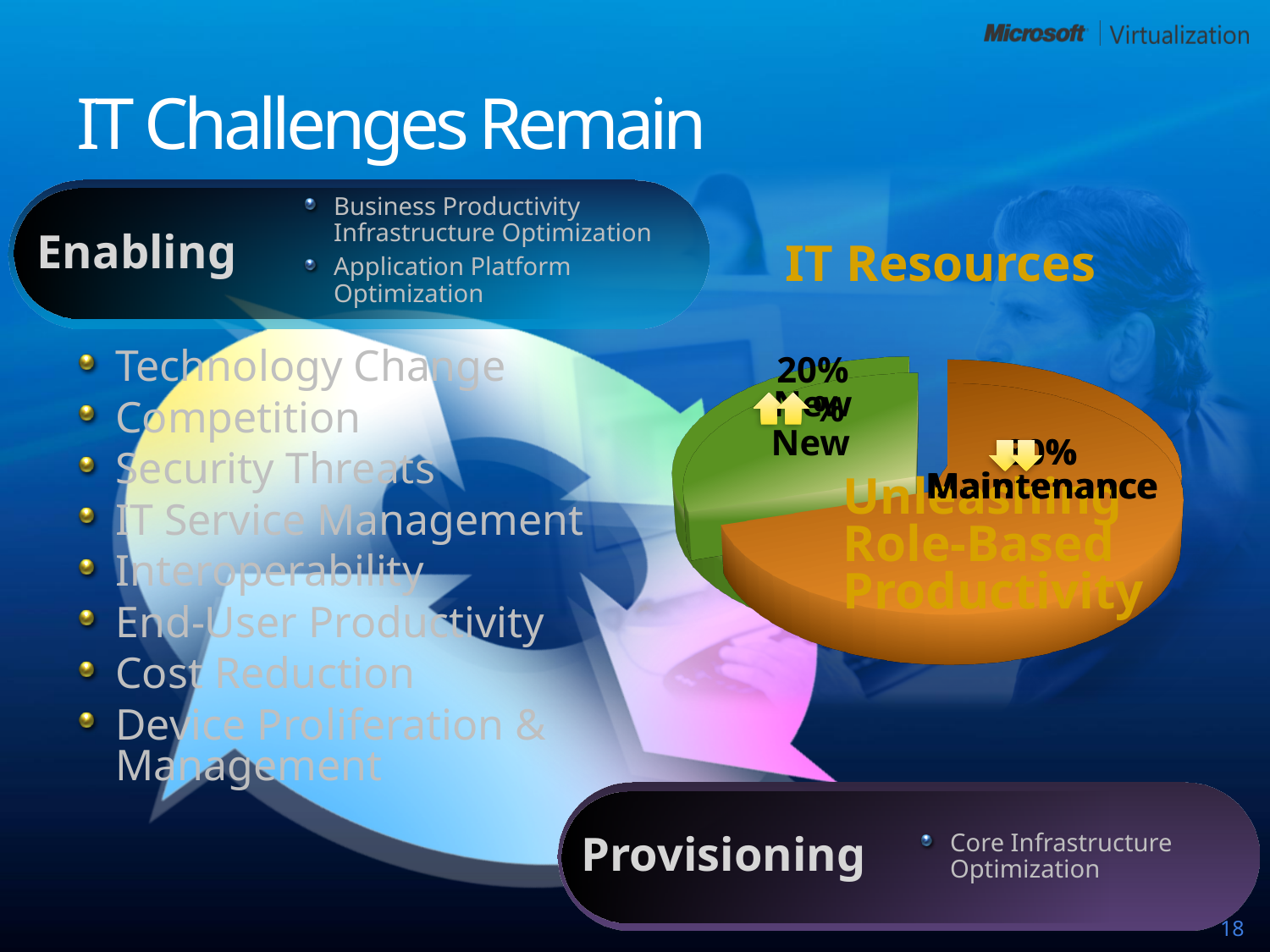
What is the title shown above the pie chart? IT Resources Which slice of the IT Resources pie chart is the largest? Maintenance In the IT Resources pie chart, which is larger: the Maintenance slice or the New slice? Maintenance What share of the IT Resources pie does the New slice represent? 20% Which slice of the IT Resources pie chart is the smallest? New In the IT Resources pie chart, what percentage is labelled for the New slice? 20% What kind of chart is shown under the heading "IT Resources"? pie chart What colour is the New slice in the IT Resources pie chart? green How many slices does the IT Resources pie chart have? 2